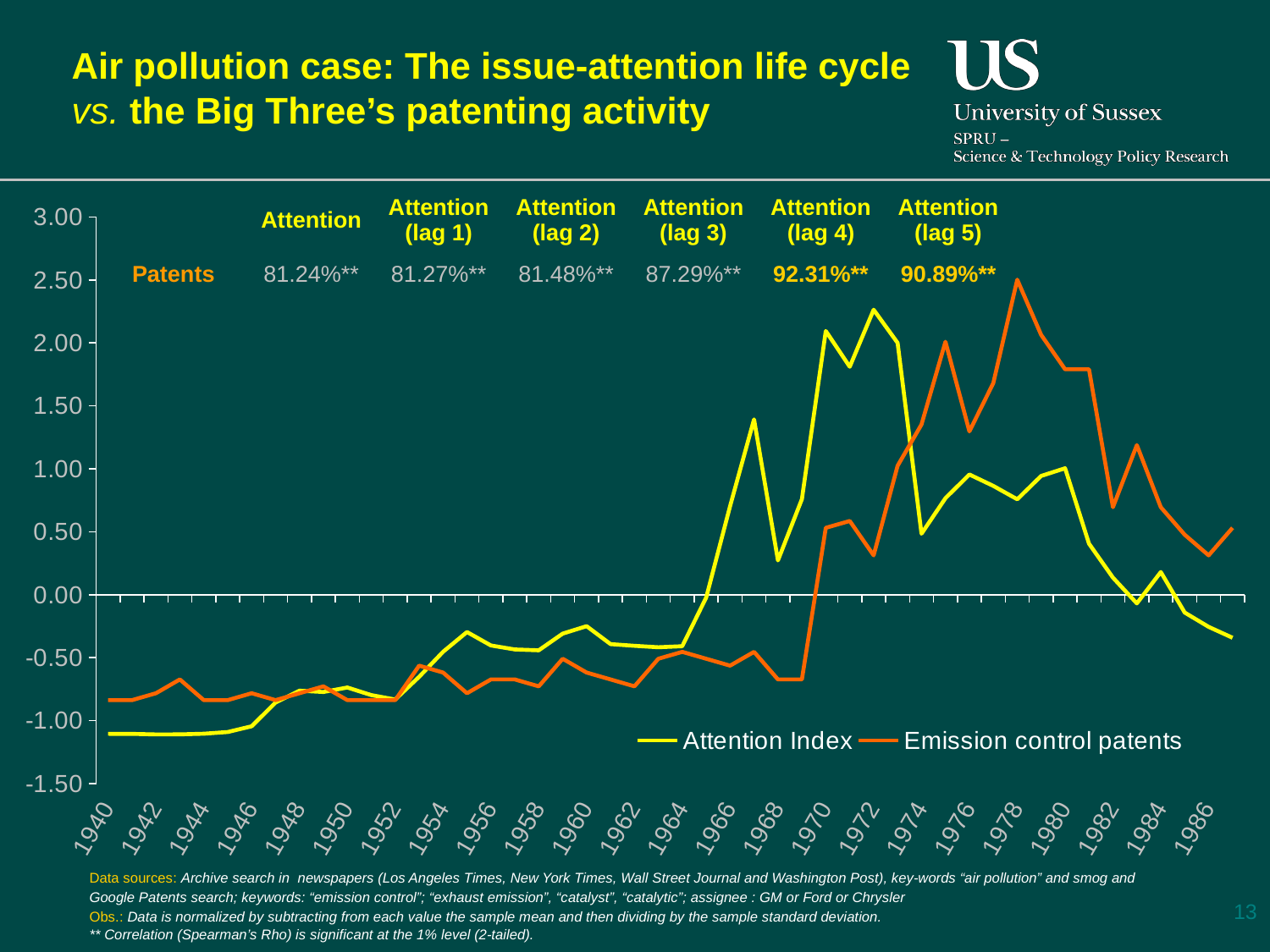
In which year does the Emission control patents series reach its highest value? 1978 Does the Attention Index generally rise or fall between 1972 and 1986? fall What kind of chart is shown on the slide? line chart Is the Emission control patents value for 1978 greater or less than 2.00? greater Is the Emission control patents value for 1968 greater or less than 0.00? less Is the Attention Index value for 1972 greater or less than 2.00? greater What are the two series named in the chart legend? Attention Index and Emission control patents In 1978, which series has the higher value, Attention Index or Emission control patents? Emission control patents In 1972, which series has the higher value, Attention Index or Emission control patents? Attention Index Which series is drawn in orange? Emission control patents How many series does the chart legend list? 2